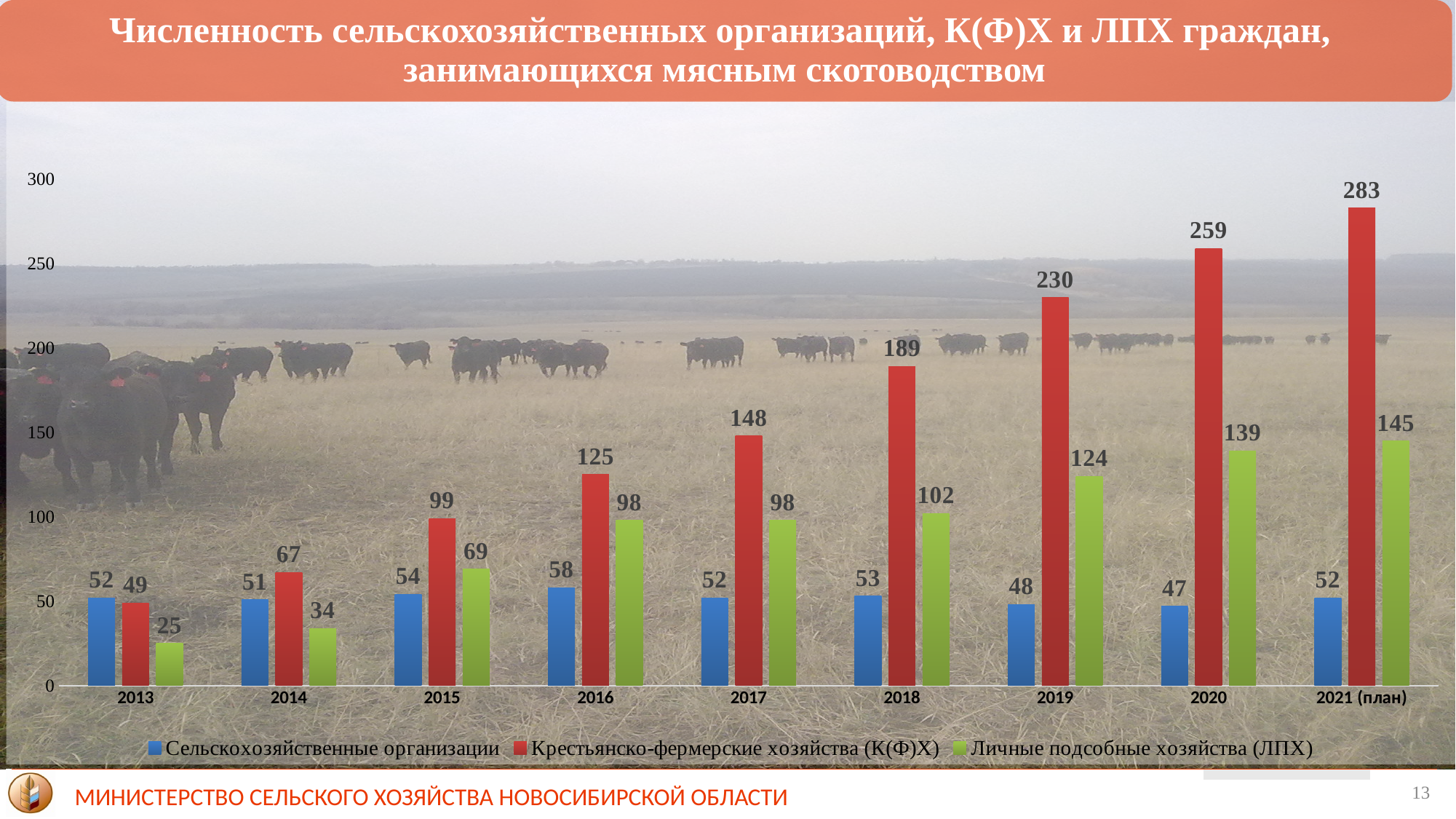
In which year is the value for Сельскохозяйственные организации lowest? 2020 What is the value for Крестьянско-фермерские хозяйства (К(Ф)Х) in 2018? 189 Is the value for ЛПХ in 2021 (план) greater or less than 100? greater Do the values for Крестьянско-фермерские хозяйства (К(Ф)Х) rise or fall from 2013 to 2021 (план)? rise How many years are shown on the x axis? 9 What is the value for Сельскохозяйственные организации in 2016? 58 How many series does the legend list? 3 What kind of chart is shown on the slide? bar chart What is the difference between the К(Ф)Х value in 2020 and in 2019? 29 Which is larger in 2015: the value for К(Ф)Х or the value for ЛПХ? К(Ф)Х In which year is the value for Крестьянско-фермерские хозяйства (К(Ф)Х) highest? 2021 (план) What is the value for Личные подсобные хозяйства (ЛПХ) in 2013? 25